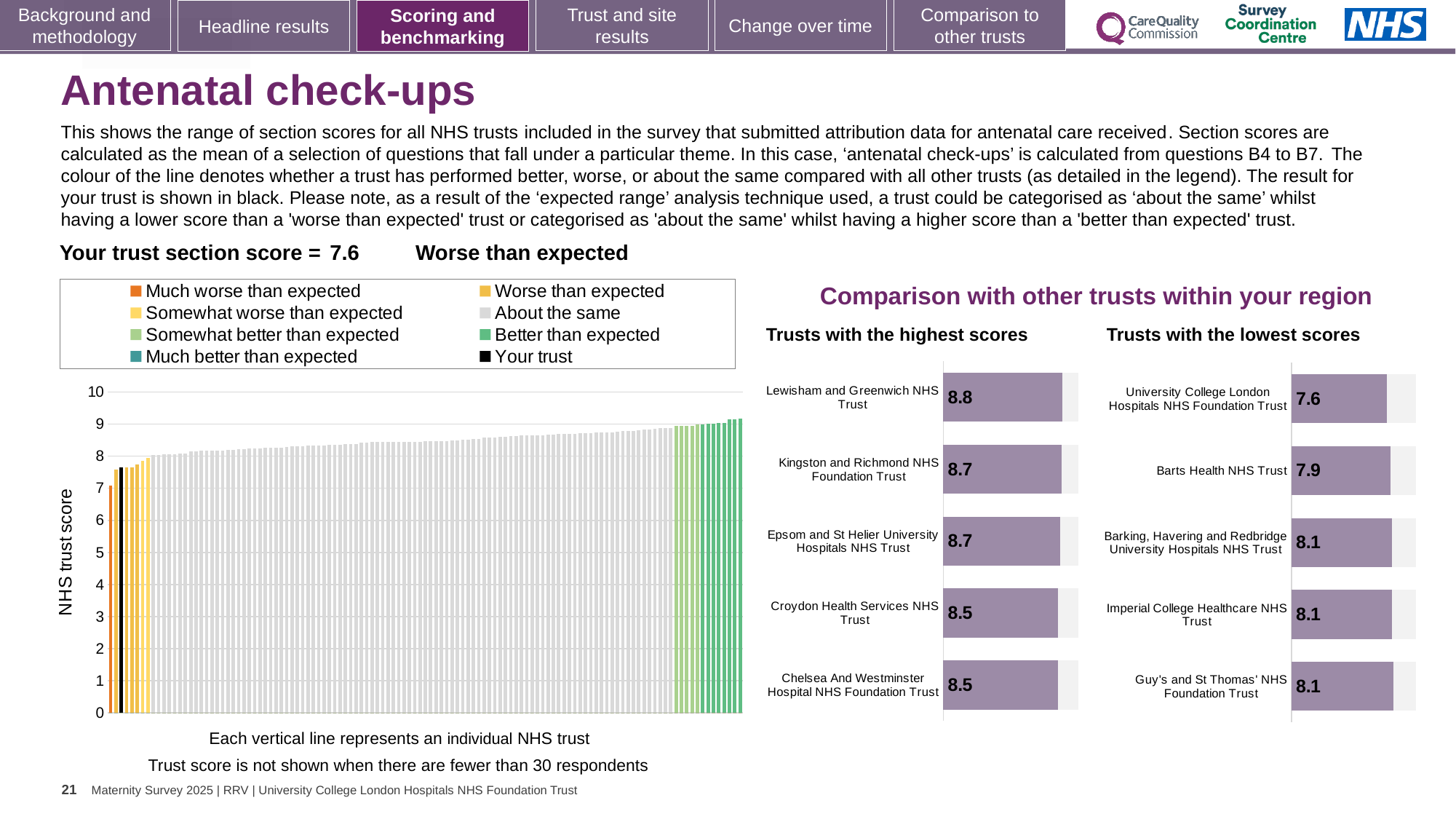
How many trusts are shown in the 'Trusts with the lowest scores' chart? 5 In the 'Trusts with the lowest scores' chart, what is the difference between the scores of Guy's and St Thomas' NHS Foundation Trust and University College London Hospitals NHS Foundation Trust? 0.5 In the 'Trusts with the lowest scores' chart, which trust has the lowest score? University College London Hospitals NHS Foundation Trust How many entries does the legend above the large chart on the left list? 8 In the 'Trusts with the highest scores' chart, which trust has the highest score? Lewisham and Greenwich NHS Trust In the 'Trusts with the lowest scores' chart, is the value for Imperial College Healthcare NHS Trust greater or less than 8? greater What kind of chart is the large chart on the left showing NHS trust scores? Bar chart In the large chart on the left, do the trust scores rise or fall from left to right? Rise In the 'Trusts with the highest scores' chart, which has the higher score: Kingston and Richmond NHS Foundation Trust or Croydon Health Services NHS Trust? Kingston and Richmond NHS Foundation Trust In the 'Trusts with the lowest scores' chart, what is the score for Barts Health NHS Trust? 7.9 In the 'Trusts with the highest scores' chart, what is the score for Lewisham and Greenwich NHS Trust? 8.8 In the 'Trusts with the highest scores' chart, what is the difference between the scores of Lewisham and Greenwich NHS Trust and Croydon Health Services NHS Trust? 0.3